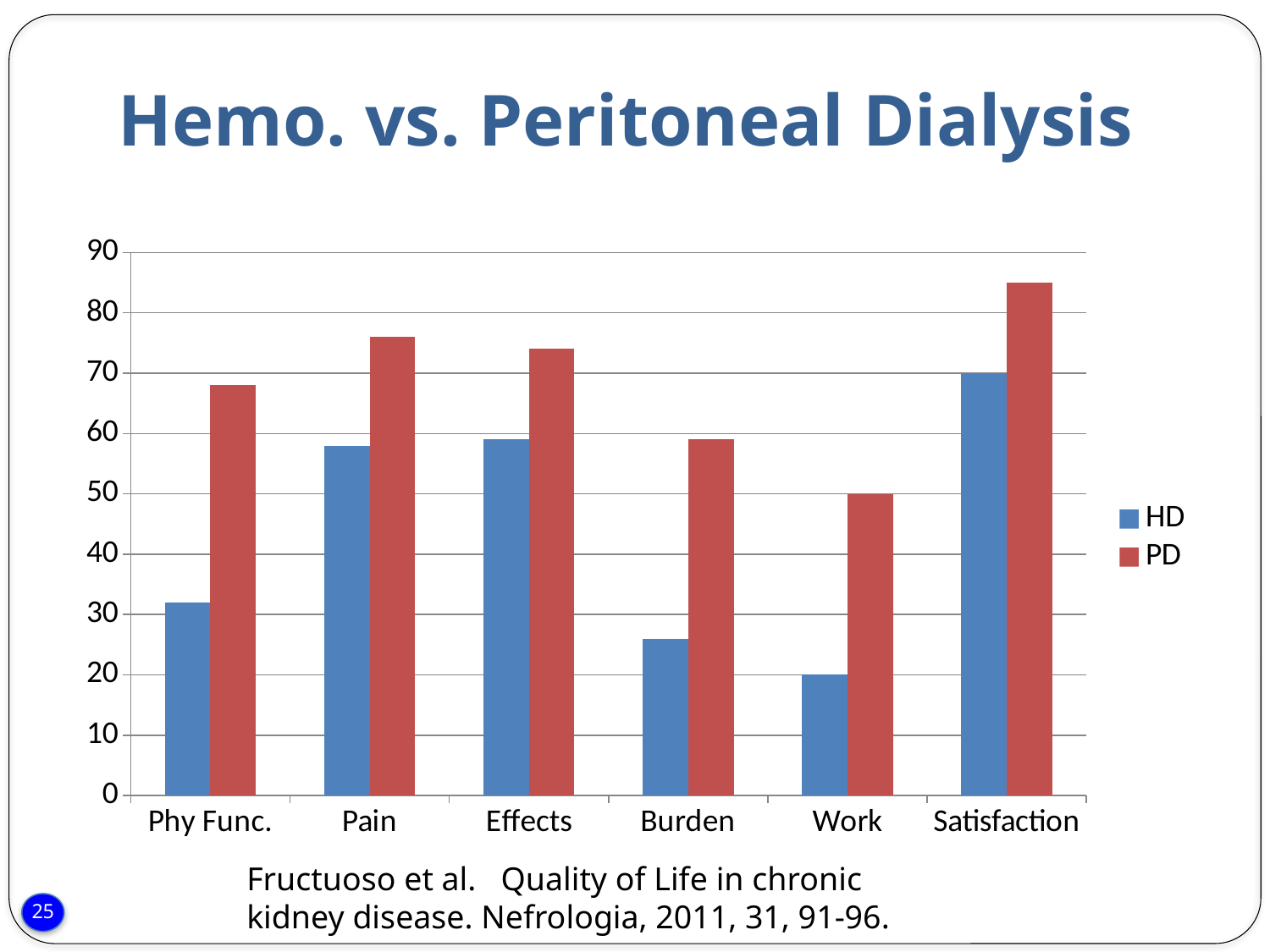
Which category has the highest PD value? Satisfaction Is the PD value for Pain greater or less than 70? greater Which category has the lowest HD value? Work Which category has the highest HD value? Satisfaction For Phy Func., which series has the larger value, HD or PD? PD What is the title of the slide containing the chart? Hemo. vs. Peritoneal Dialysis Which category has the lowest PD value? Work What kind of chart is shown on the slide? bar chart Is the HD value for Phy Func. greater or less than 40? less Is the PD value for Burden greater or less than 50? greater How many series does the legend list? 2 How many categories are shown on the x axis? 6